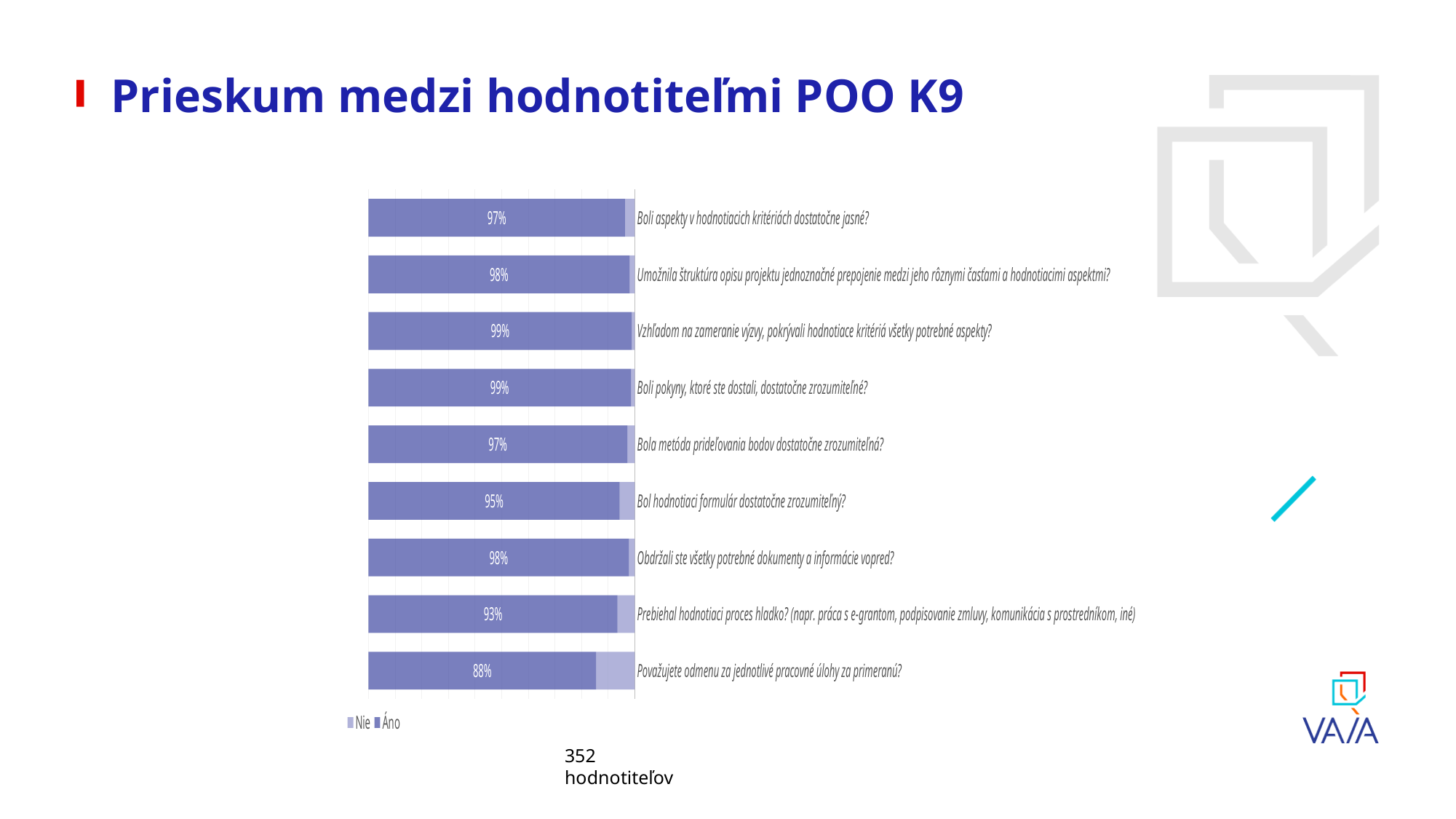
What is the Áno percentage for "Prebiehal hodnotiaci proces hladko? (napr. práca s e-grantom, podpisovanie zmluvy, komunikácia s prostredníkom, iné)" 93% What is the highest Áno percentage shown in the chart? 99% What is the Áno percentage for "Boli aspekty v hodnotiacich kritériách dostatočne jasné?" 97% Which has a higher Áno percentage: "Umožnila štruktúra opisu projektu jednoznačné prepojenie medzi jeho rôznymi časťami a hodnotiacimi aspektmi?" or "Prebiehal hodnotiaci proces hladko?" Umožnila štruktúra opisu projektu jednoznačné prepojenie medzi jeho rôznymi časťami a hodnotiacimi aspektmi? What are the two legend entries of the chart? Nie, Áno What is the Áno percentage for "Obdržali ste všetky potrebné dokumenty a informácie vopred?" 98% How many series does the legend list? 2 What type of chart is shown on the slide? bar chart Which question has the lowest Áno percentage? Považujete odmenu za jednotlivé pracovné úlohy za primeranú? What is the Áno percentage for "Bol hodnotiaci formulár dostatočne zrozumiteľný?" 95% What is the difference in Áno percentage between "Bola metóda prideľovania bodov dostatočne zrozumiteľná?" and "Považujete odmenu za jednotlivé pracovné úlohy za primeranú?" 9 percentage points How many questions (categories) are plotted in the chart? 9